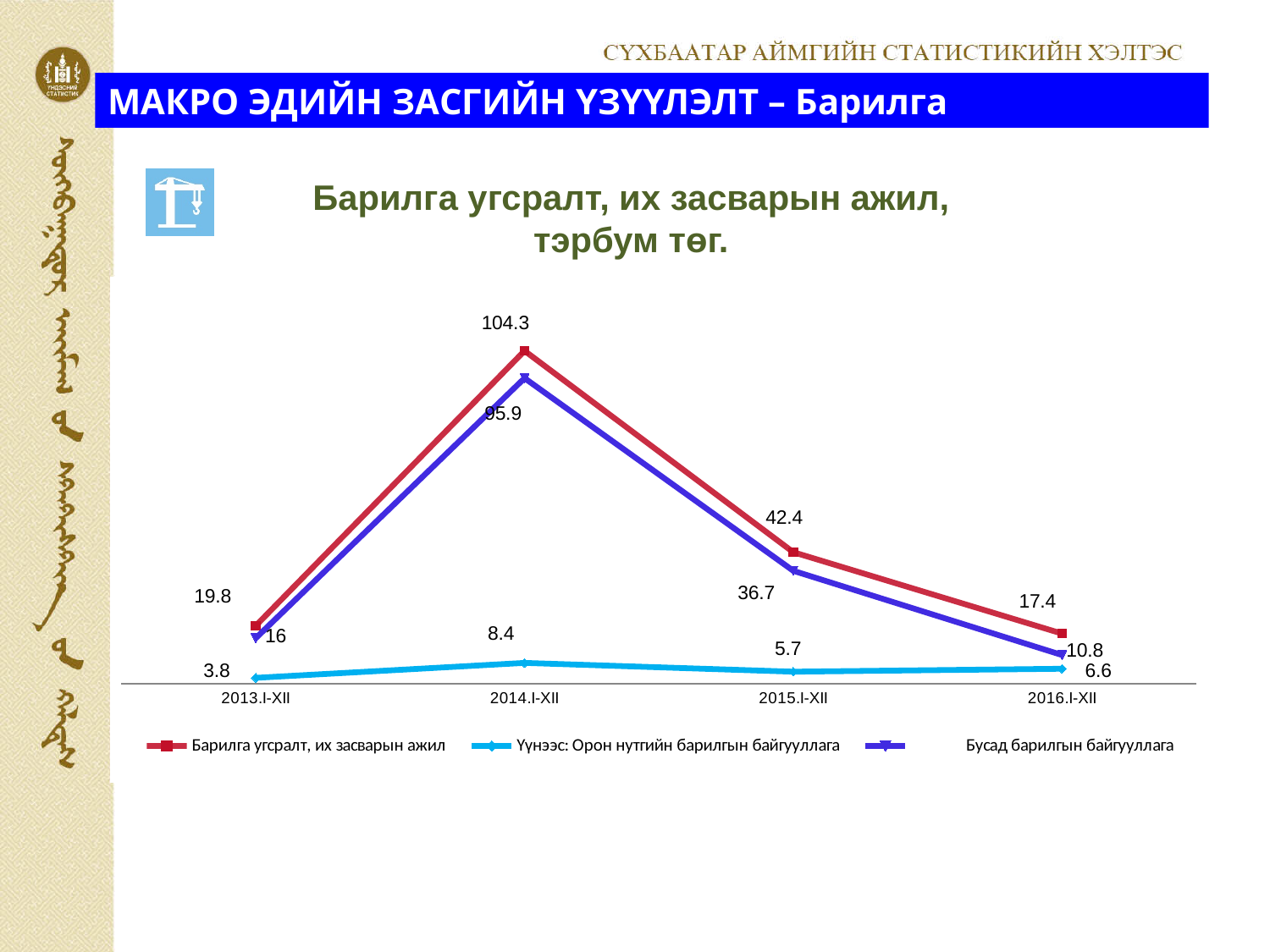
What is the value for Үүнээс: Орон нутгийн барилгын байгууллага in 2015.I-XII? 5.7 What is the value for Бусад барилгын байгууллага in 2016.I-XII? 10.8 What type of chart is shown on the slide? line chart How many series does the legend list? 3 Which is larger in 2013.I-XII: Барилга угсралт, их засварын ажил or Бусад барилгын байгууллага? Барилга угсралт, их засварын ажил In which period is the value for Үүнээс: Орон нутгийн барилгын байгууллага lowest? 2013.I-XII What is the difference between the Барилга угсралт, их засварын ажил values in 2014.I-XII and 2015.I-XII? 61.9 What is the value for Барилга угсралт, их засварын ажил in 2014.I-XII? 104.3 What is the title of the chart? Барилга угсралт, их засварын ажил, тэрбум төг. In which period is the value for Барилга угсралт, их засварын ажил highest? 2014.I-XII Does the value for Барилга угсралт, их засварын ажил rise or fall from 2014.I-XII to 2016.I-XII? fall How many time periods are shown on the x axis? 4